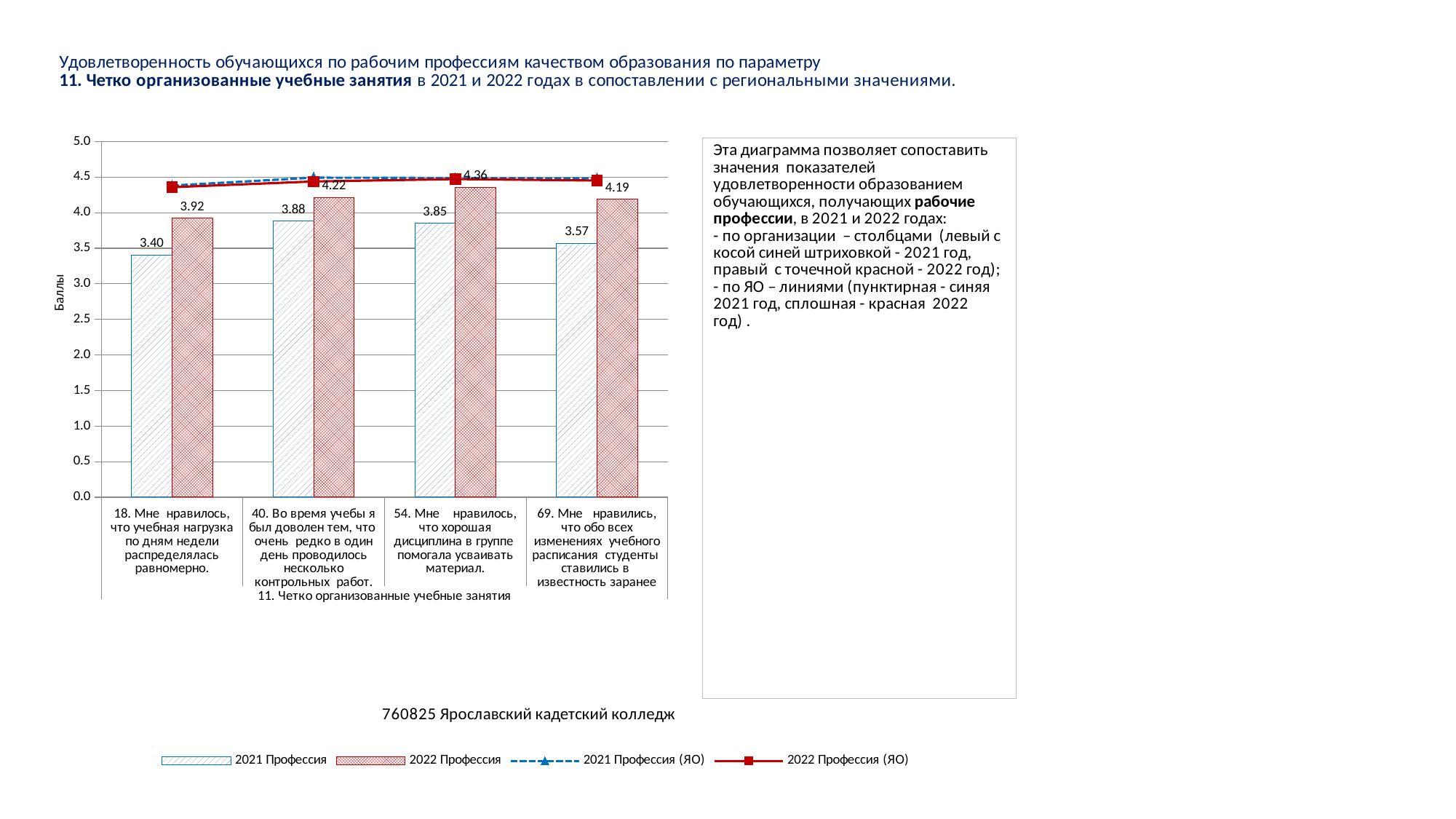
What is the label of the vertical axis? Баллы What is the value of the 2021 Профессия bar for category 18 (Мне нравилось, что учебная нагрузка по дням недели распределялась равномерно)? 3.40 Which category has the lowest 2021 Профессия value? 18. Мне нравилось, что учебная нагрузка по дням недели распределялась равномерно. What is the value of the 2022 Профессия bar for category 69 (Мне нравились, что обо всех изменениях учебного расписания студенты ставились в известность заранее)? 4.19 What kind of chart is shown on the slide? Bar chart (with line series) Is the 2021 Профессия (ЯО) line value for category 18 greater or less than 4.0? greater Which is larger: the 2021 Профессия value for category 18 or for category 69? Category 69 (3.57) What is the difference between the 2022 and 2021 Профессия values for category 18? 0.52 Which category has the highest 2022 Профессия value? 54. Мне нравилось, что хорошая дисциплина в группе помогала усваивать материал. What is the value of the 2022 Профессия bar for category 54 (Мне нравилось, что хорошая дисциплина в группе помогала усваивать материал)? 4.36 How many categories are shown on the x axis? 4 How many series does the legend list? 4